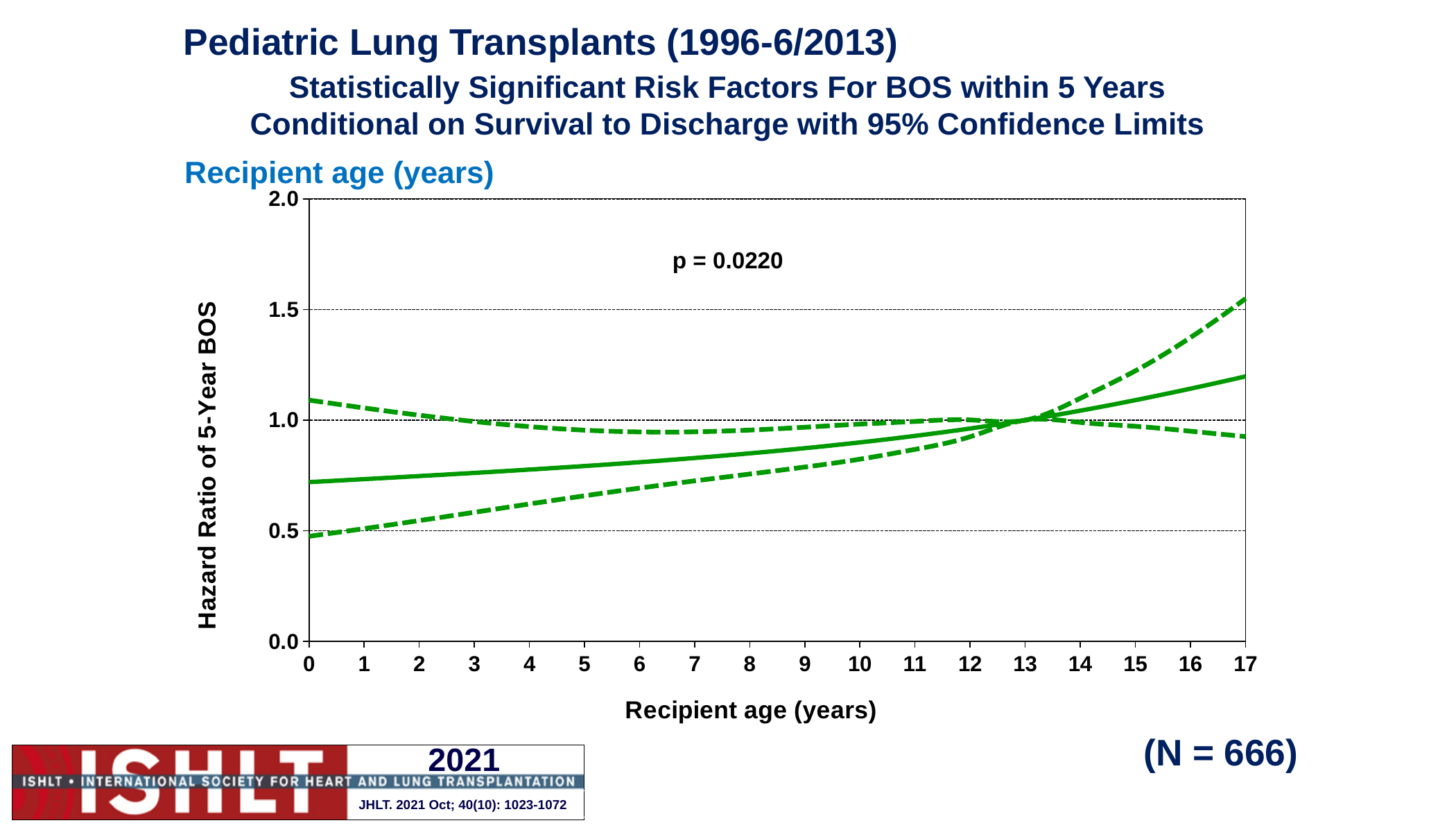
How many lines are plotted on the chart? 3 What is the p-value printed on the chart? p = 0.0220 Does the solid hazard ratio line rise or fall as recipient age increases from 0 to 17 years? rise What kind of chart is shown on the slide? line chart Is the upper dashed confidence limit at recipient age 0 greater or less than 1.0? greater How many tick labels are shown on the x axis? 18 What is the sample size (N) shown on the slide? N = 666 Is the lower dashed confidence limit at recipient age 17 greater or less than 1.0? less Is the solid hazard ratio line at recipient age 5 greater or less than 1.0? less